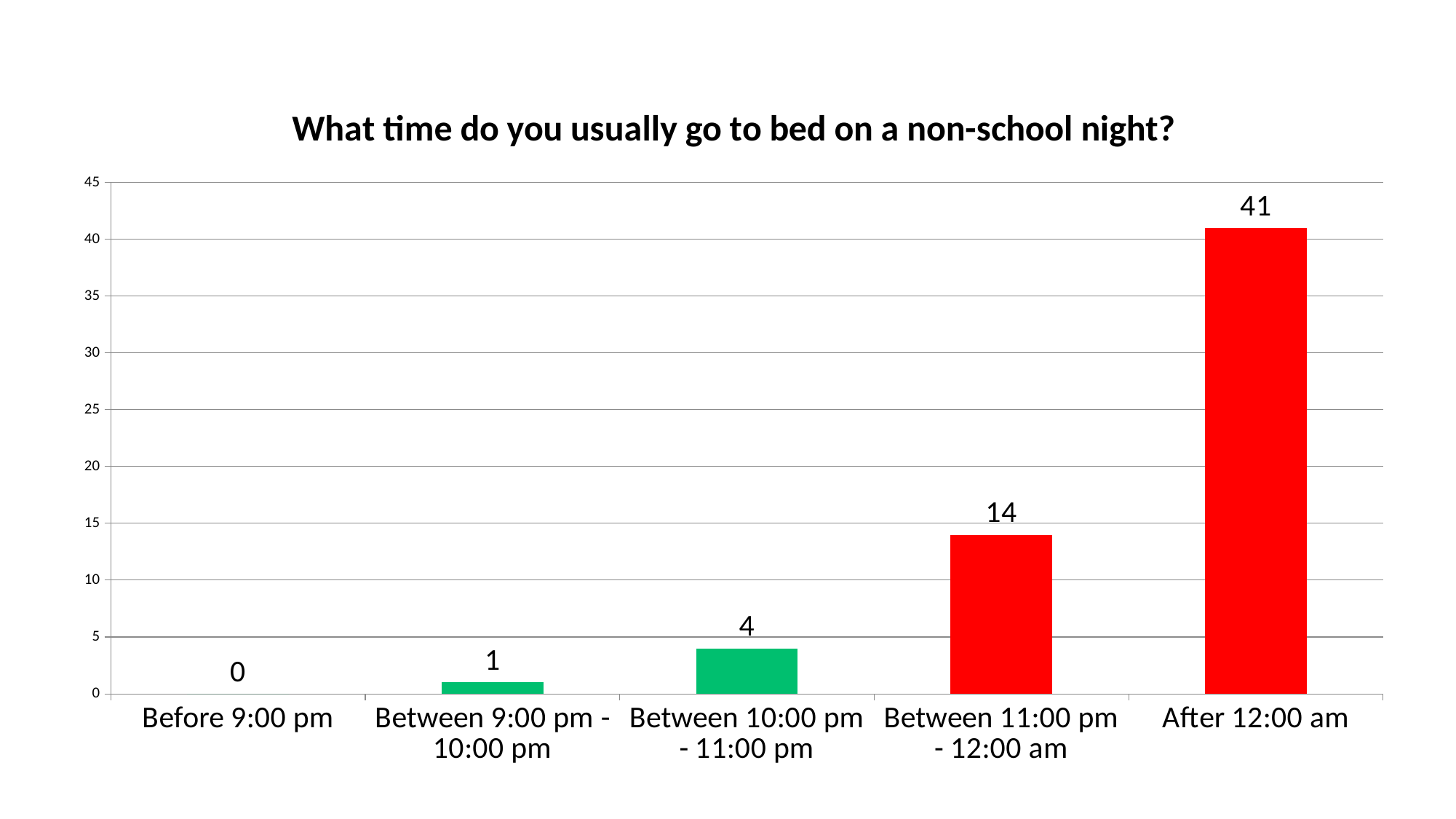
Which is larger, the value for "Between 9:00 pm - 10:00 pm" or the value for "Between 10:00 pm - 11:00 pm"? Between 10:00 pm - 11:00 pm Is the value for "After 12:00 am" greater or less than 35? greater Which category has the lowest value? Before 9:00 pm What is the value for "After 12:00 am"? 41 What kind of chart is shown on the slide? bar chart What is the value for "Between 10:00 pm - 11:00 pm"? 4 What is the title of the chart? What time do you usually go to bed on a non-school night? What is the value for "Between 11:00 pm - 12:00 am"? 14 Which category has the highest value? After 12:00 am What is the difference between the values for "After 12:00 am" and "Between 11:00 pm - 12:00 am"? 27 How many categories are shown on the x axis? 5 What is the value for "Before 9:00 pm"? 0